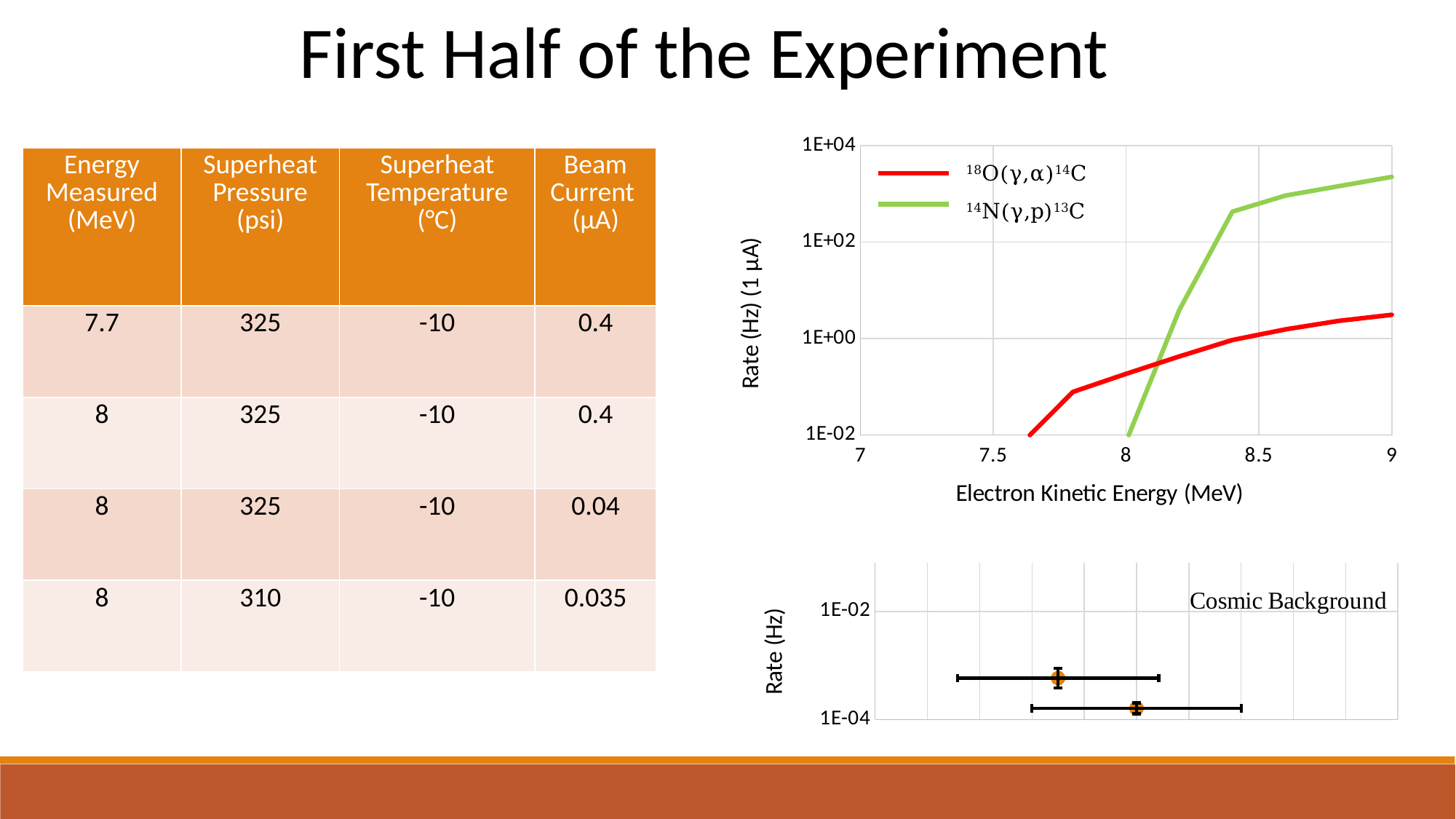
In the top-right chart, is the rate for 14N(γ,p)13C at 9 MeV greater or less than 1E+02? greater In the bottom-right Cosmic Background chart, are both plotted rates greater or less than 1E-02 Hz? less In the top-right chart, what is the label of the x axis? Electron Kinetic Energy (MeV) In the top-right chart, how many series does the legend list? 2 In the top-right chart, does the rate for 14N(γ,p)13C rise or fall as electron kinetic energy increases? rise In the top-right chart, is the rate for 18O(γ,α)14C at 8 MeV greater or less than 1E+00? less In the top-right chart, which colour is the line for the 14N(γ,p)13C series? green In the top-right chart, does the rate for 18O(γ,α)14C rise or fall as electron kinetic energy increases? rise In the top-right chart, at 9 MeV, which series has the higher rate, 18O(γ,α)14C or 14N(γ,p)13C? 14N(γ,p)13C What kind of chart is the top-right chart with the Electron Kinetic Energy axis? line chart